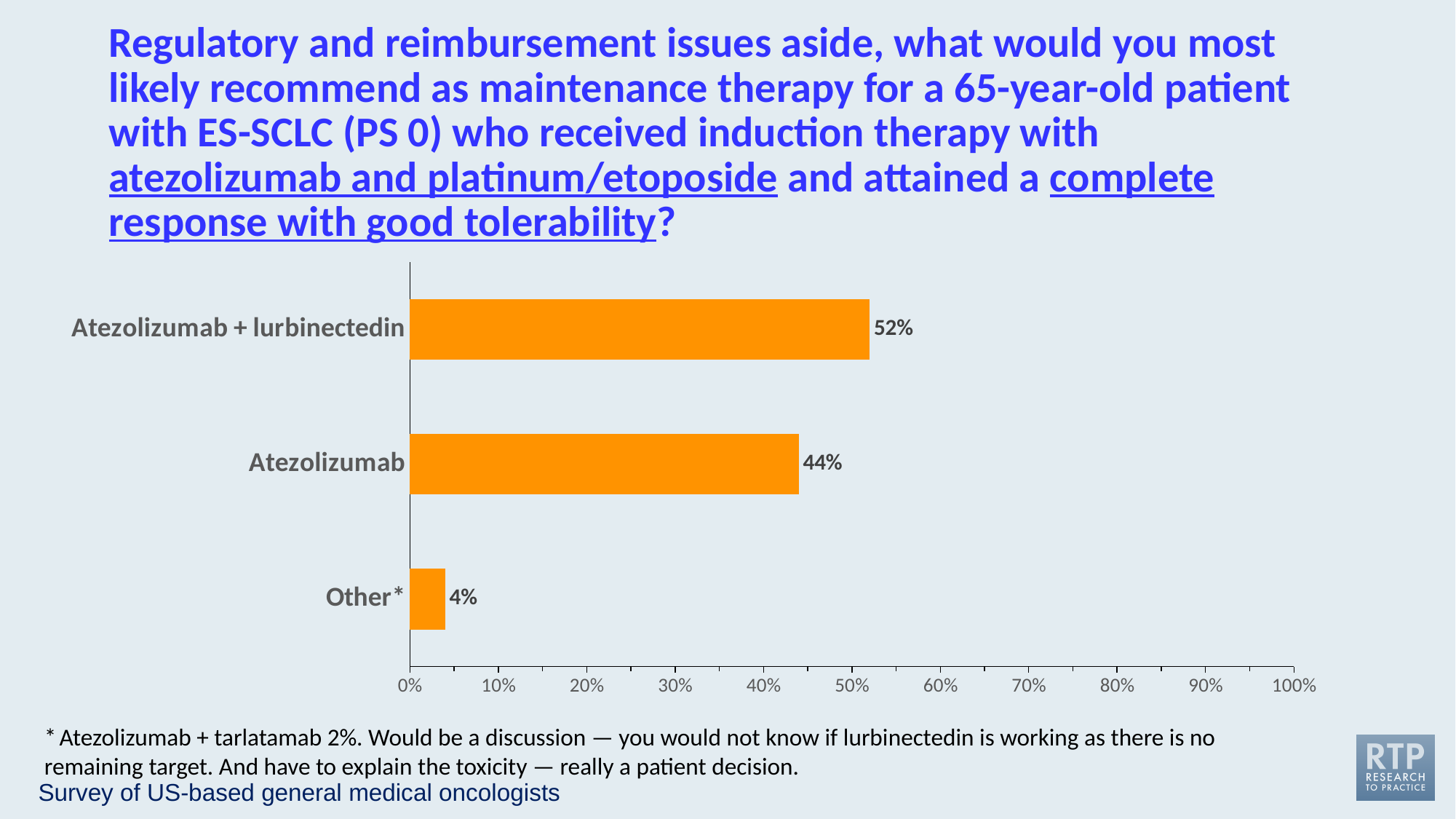
Is the value for Atezolizumab + lurbinectedin greater or less than 50%? greater Which received a larger share of responses, Atezolizumab or Other*? Atezolizumab What percentage of respondents chose Atezolizumab alone? 44% Which option received the lowest percentage of responses? Other* Is the value for Atezolizumab greater or less than 50%? less Which option received the highest percentage of responses? Atezolizumab + lurbinectedin How many response categories are shown in the chart? 3 What percentage of respondents chose Other*? 4% What is the maximum value shown on the x axis of the chart? 100% What type of chart is shown on the slide? Bar chart What percentage of respondents chose Atezolizumab + lurbinectedin? 52% What is the difference in percentage points between Atezolizumab + lurbinectedin and Atezolizumab? 8 percentage points